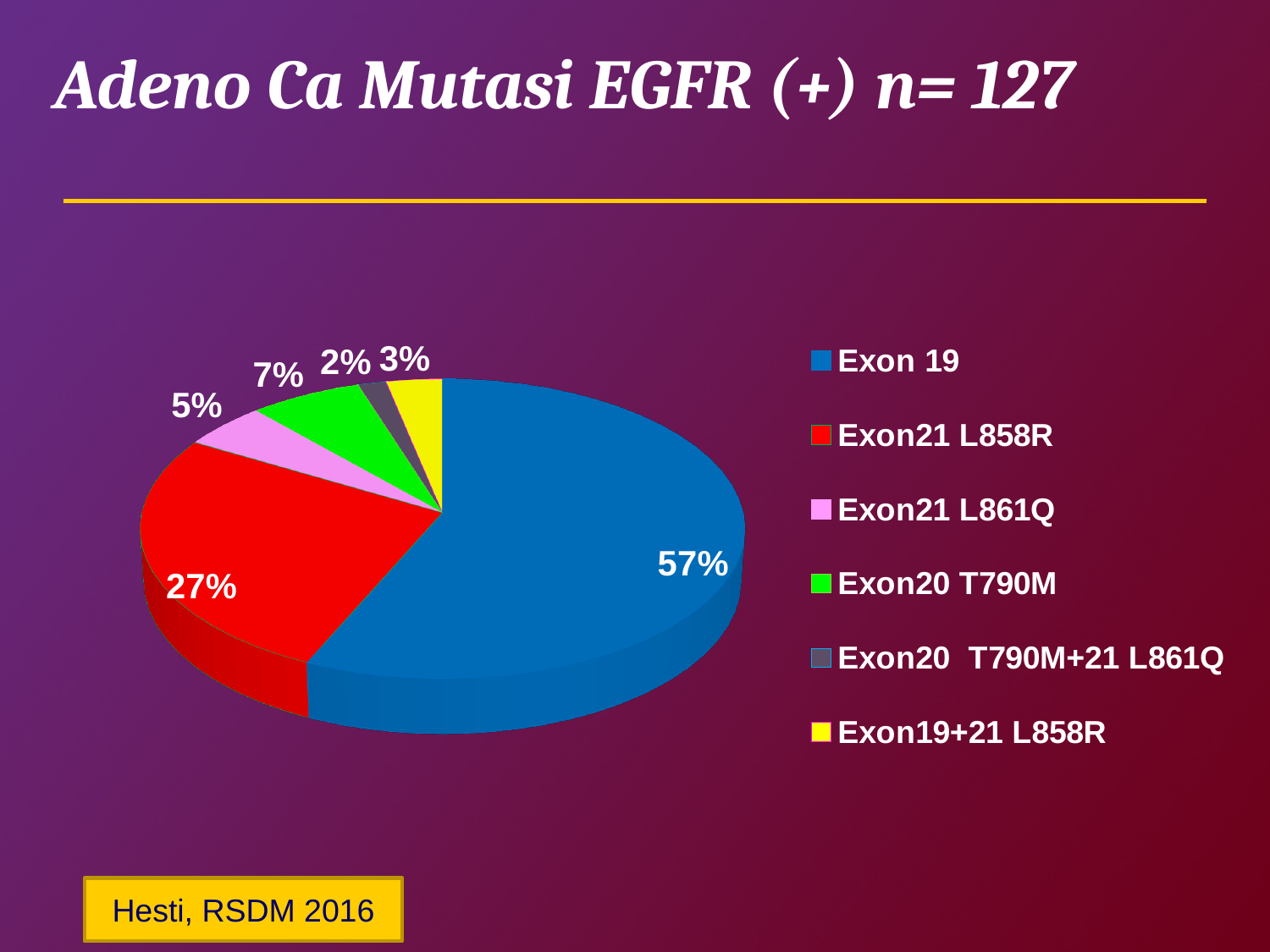
What is the difference between the shares of Exon 19 and Exon21 L858R? 30% What is the value shown for Exon19+21 L858R? 3% What colour is the slice for Exon19+21 L858R? Yellow What kind of chart is shown on the slide? Pie chart What share of the pie does Exon 19 account for? 57% Which category has the largest slice of the pie? Exon 19 What is the value shown for Exon21 L858R? 27% What is the value shown for Exon21 L861Q? 5% What is the value shown for Exon20 T790M? 7% Which is larger, the share for Exon20 T790M or the share for Exon21 L861Q? Exon20 T790M Which category has the smallest slice of the pie? Exon20 T790M+21 L861Q How many categories does the pie chart have? 6